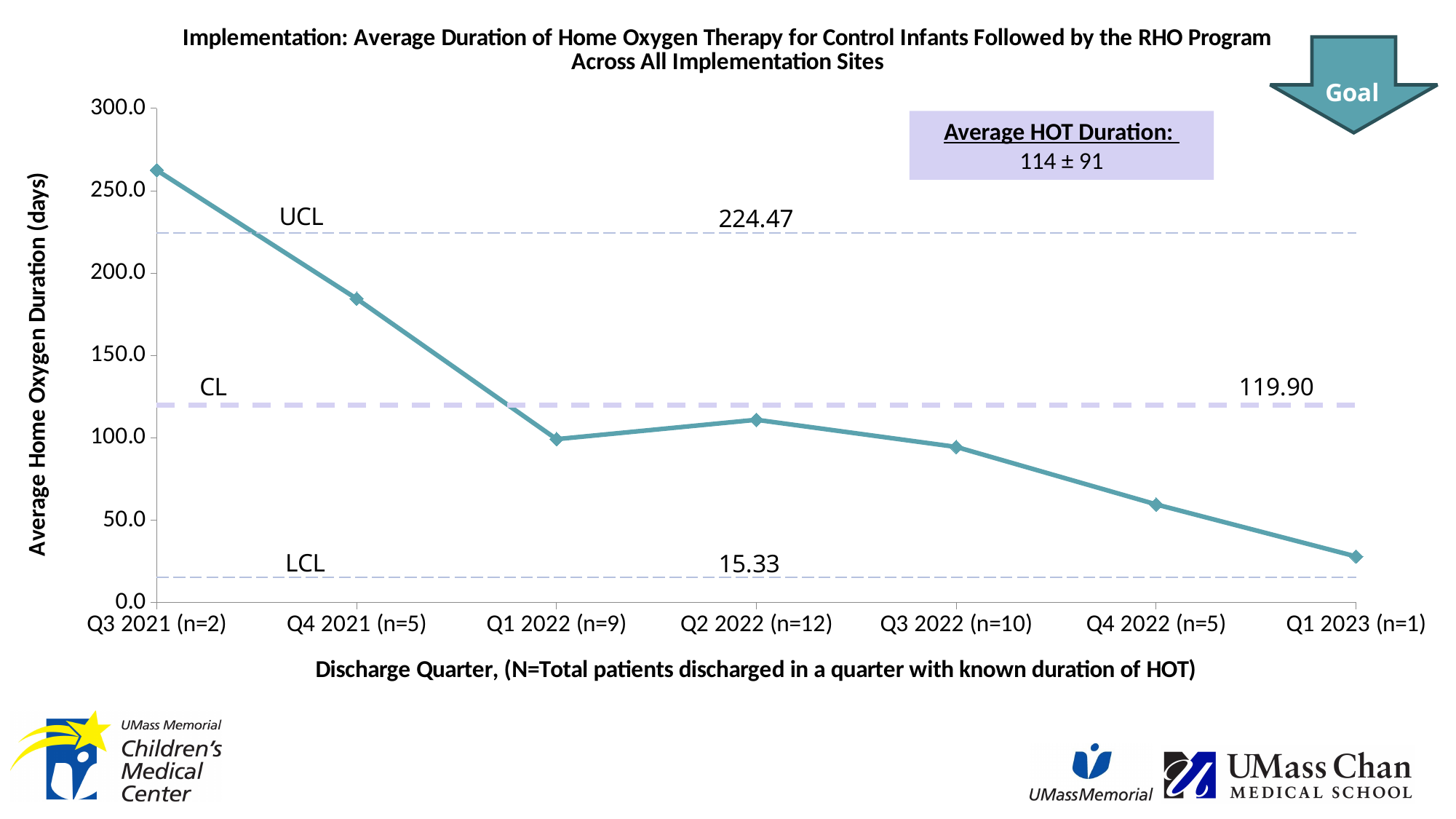
Which discharge quarter has the lowest average home oxygen duration? Q1 2023 (n=1) What is the value of the LCL line? 15.33 What is the difference between the UCL and the LCL values? 209.14 How many discharge quarters are plotted on the x axis? 7 What is the Average HOT Duration stated in the box on the chart? 114 ± 91 What kind of chart is shown on the slide? line chart Which is larger, the value for Q4 2021 (n=5) or the value for Q2 2022 (n=12)? Q4 2021 (n=5) What is the value of the UCL line? 224.47 Is the value for Q3 2021 (n=2) greater or less than 250? greater What is the value of the CL line? 119.90 Which discharge quarter has the highest average home oxygen duration? Q3 2021 (n=2) Is the value for Q4 2022 (n=5) greater or less than 100? less